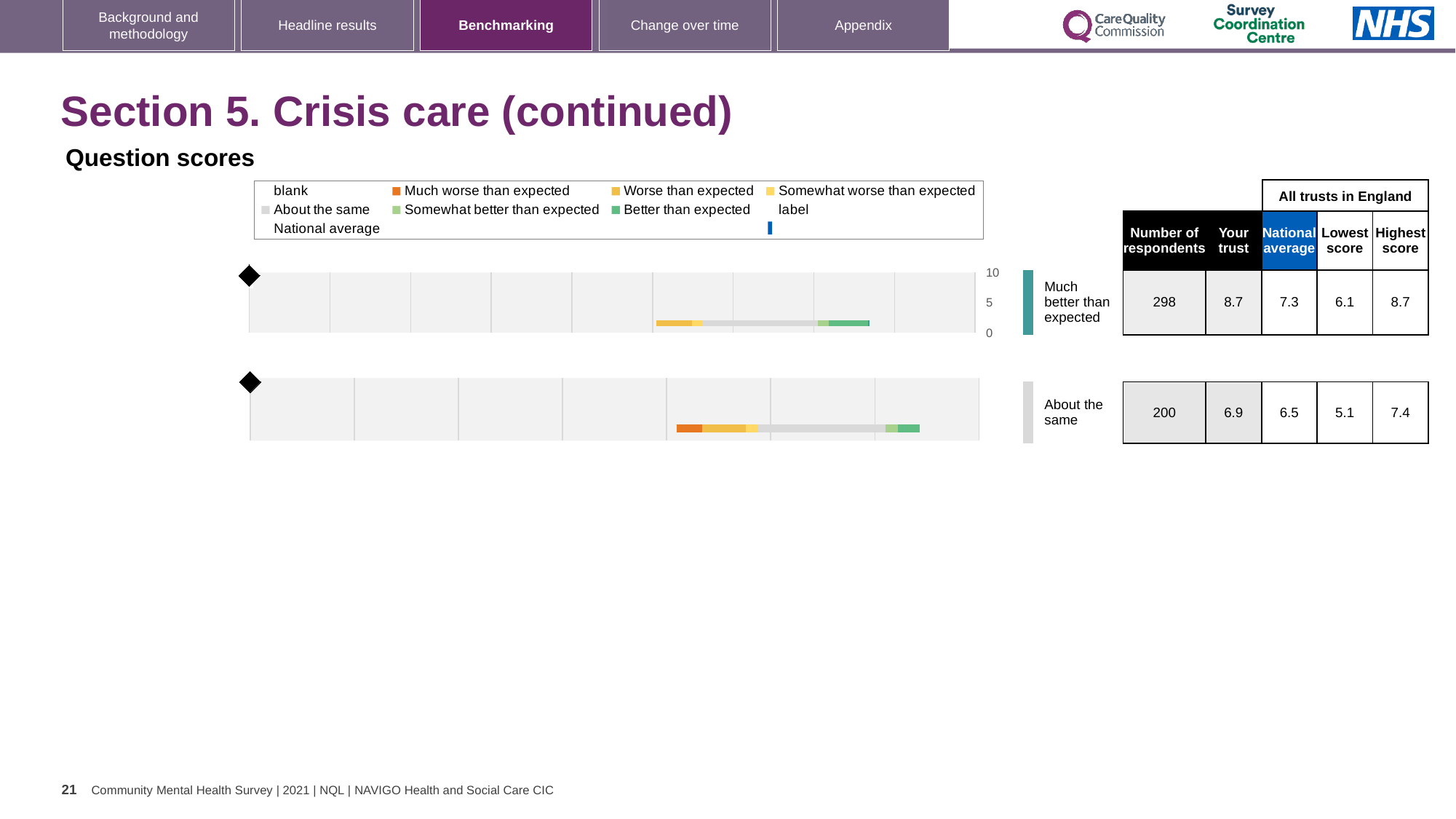
Is the 'Your trust' score for the row rated 'About the same' greater or less than 5? greater In the table, what is the lowest score across all trusts in England for the row rated 'About the same'? 5.1 How many question score charts are shown on the slide? 2 Which row has the higher 'Your trust' score: the one rated 'Much better than expected' or the one rated 'About the same'? Much better than expected In the table, what is the national average for the row rated 'Much better than expected'? 7.3 In the table, what is the number of respondents for the row rated 'About the same'? 200 In the table, what is the highest score across all trusts in England for the row rated 'About the same'? 7.4 In the table, what is the 'Your trust' score for the row rated 'Much better than expected'? 8.7 What kind of chart is used for the question scores on this slide? bar chart By how much does the 'Your trust' score exceed the national average for the row rated 'Much better than expected'? 1.4 What colour does the legend use for 'Much worse than expected'? orange In the table, what is the number of respondents for the row rated 'Much better than expected'? 298